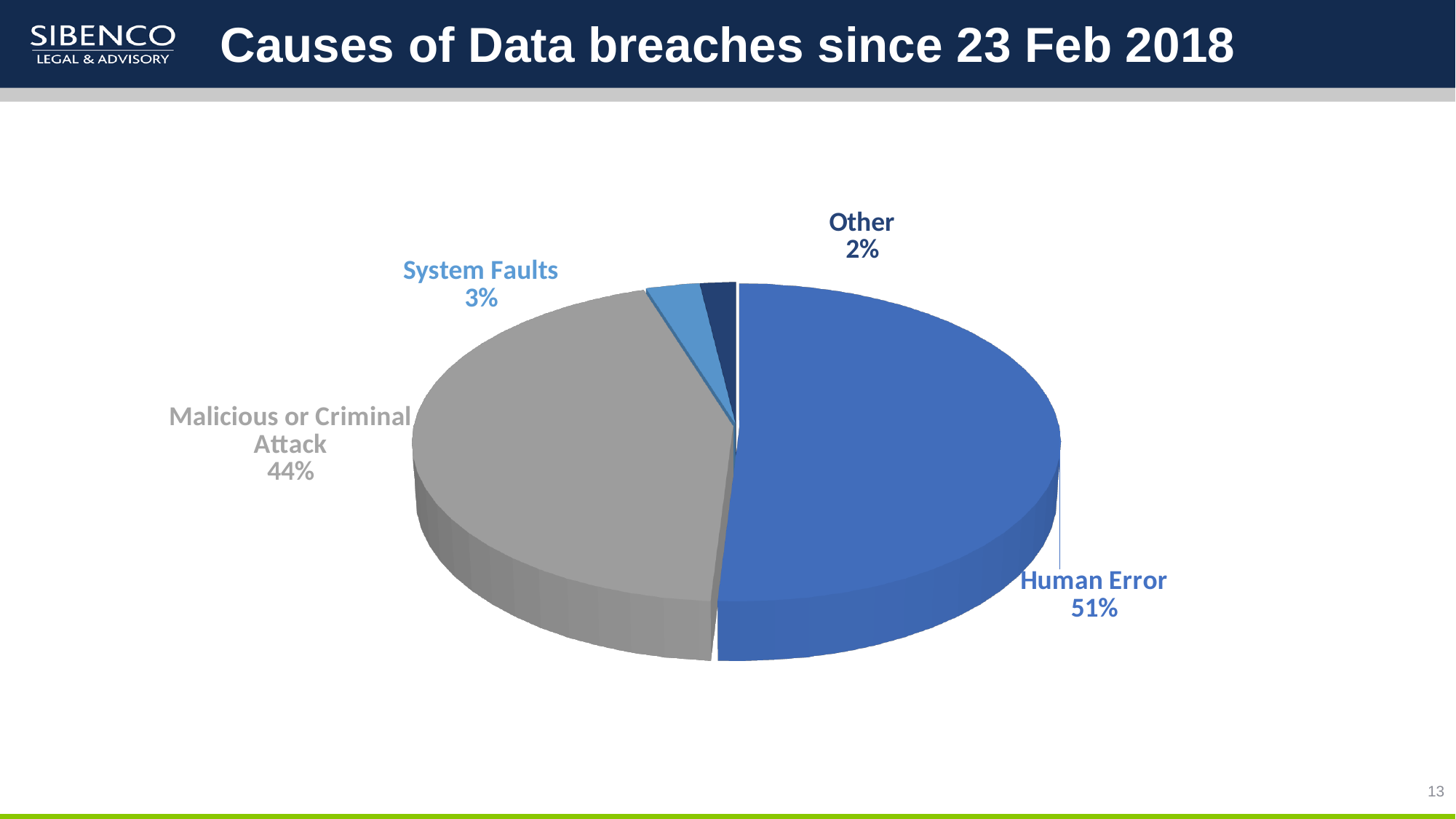
What share of data breaches is attributed to Other? 2% Which is larger, the share for System Faults or the share for Other? System Faults What is the title of the chart on the slide? Causes of Data breaches since 23 Feb 2018 How many categories are shown in the pie chart? 4 What share of data breaches is attributed to Human Error? 51% Which cause accounts for the largest share of data breaches? Human Error What share of data breaches is attributed to Malicious or Criminal Attack? 44% What is the difference in percentage points between Human Error and Malicious or Criminal Attack? 7 What colour is the Malicious or Criminal Attack slice? Grey Which cause accounts for the smallest share of data breaches? Other What kind of chart is shown on the slide? Pie chart